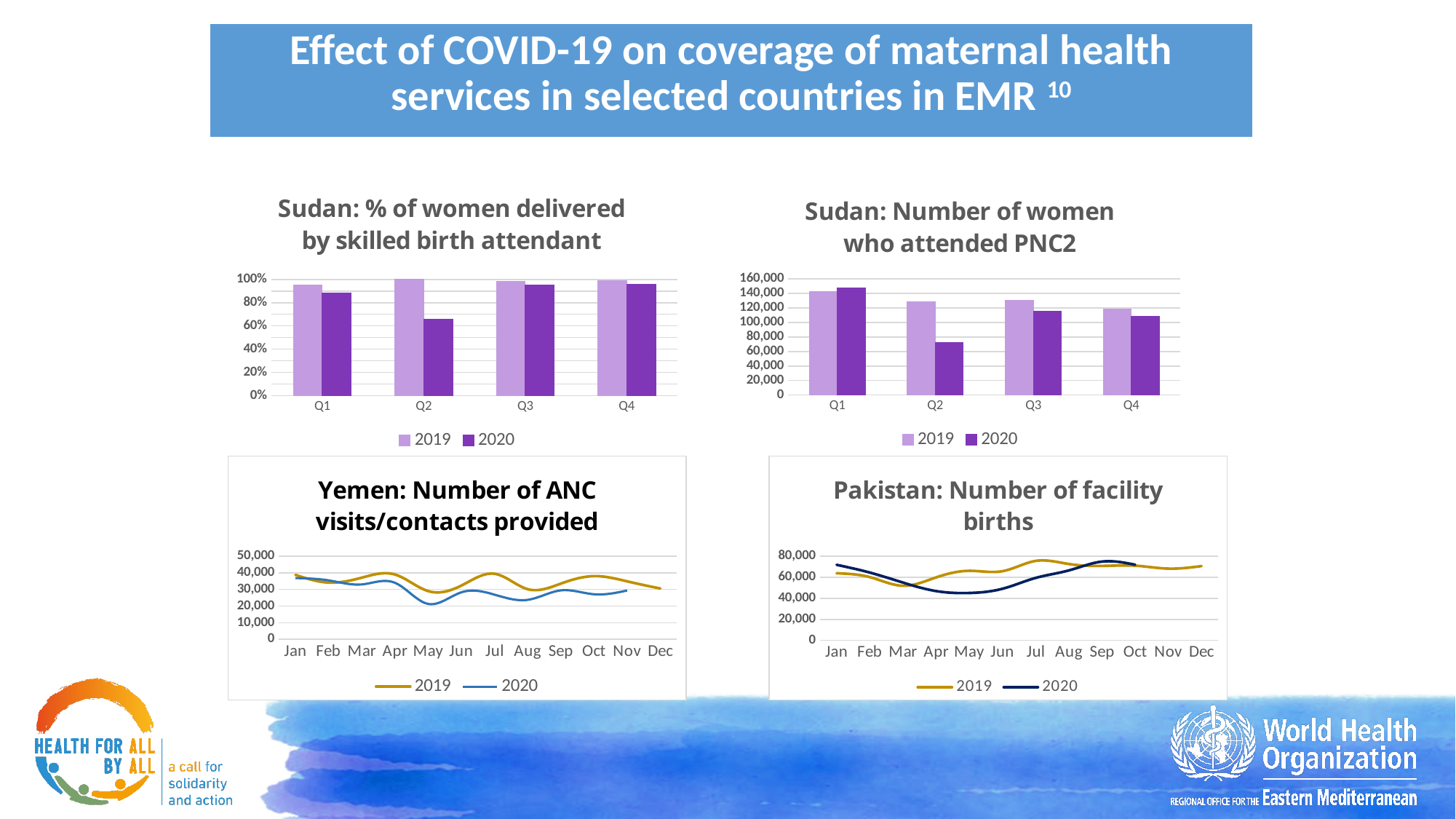
What kind of chart is the 'Pakistan: Number of facility births' chart? line chart In the 'Pakistan: Number of facility births' chart, is the 2020 value for May greater or less than 60,000? less How many quarters are shown on the x axis of the 'Sudan: Number of women who attended PNC2' chart? 4 In the 'Sudan: Number of women who attended PNC2' chart, which quarter has the lowest 2020 value? Q2 In the 'Sudan: Number of women who attended PNC2' chart, is the 2019 value for Q1 greater or less than 120,000? greater In the 'Yemen: Number of ANC visits/contacts provided' chart, is the 2020 value for May greater or less than 30,000? less In the 'Sudan: % of women delivered by skilled birth attendant' chart, which is larger for Q2, the 2019 value or the 2020 value? 2019 How many series does the legend of the 'Yemen: Number of ANC visits/contacts provided' chart list? 2 What kind of chart is the 'Sudan: % of women delivered by skilled birth attendant' chart? bar chart In the 'Pakistan: Number of facility births' chart, does the 2020 line rise or fall from May to September? rise